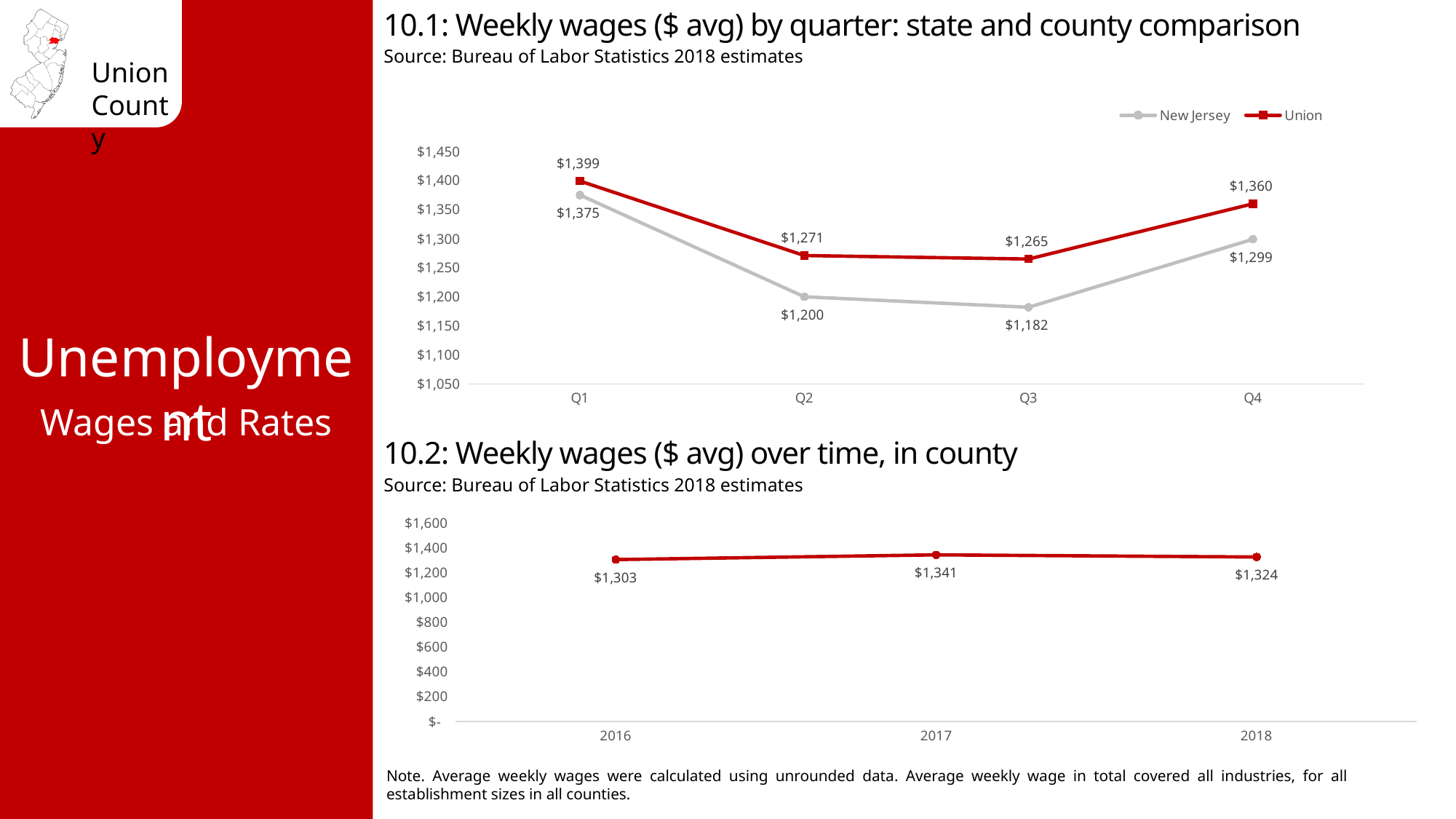
In chart 10.1, what is the difference between the Union and New Jersey weekly wages in Q4? $61 In chart 10.1, in which quarter is the New Jersey weekly wage highest? Q1 In chart 10.2, which year has the lowest weekly wage? 2016 In chart 10.2, what is the weekly wage in 2017? $1,341 In chart 10.1, what is the weekly wage for Union in Q1? $1,399 In chart 10.1, how many series does the legend list? 2 In chart 10.2, how many years are plotted? 3 In chart 10.1, which series has the higher weekly wage in Q2, New Jersey or Union? Union In chart 10.1, what is the weekly wage for New Jersey in Q3? $1,182 In chart 10.1, do the New Jersey weekly wages rise or fall from Q1 to Q3? fall In chart 10.1, in which quarter is the Union weekly wage lowest? Q3 What kind of chart is chart 10.2? line chart